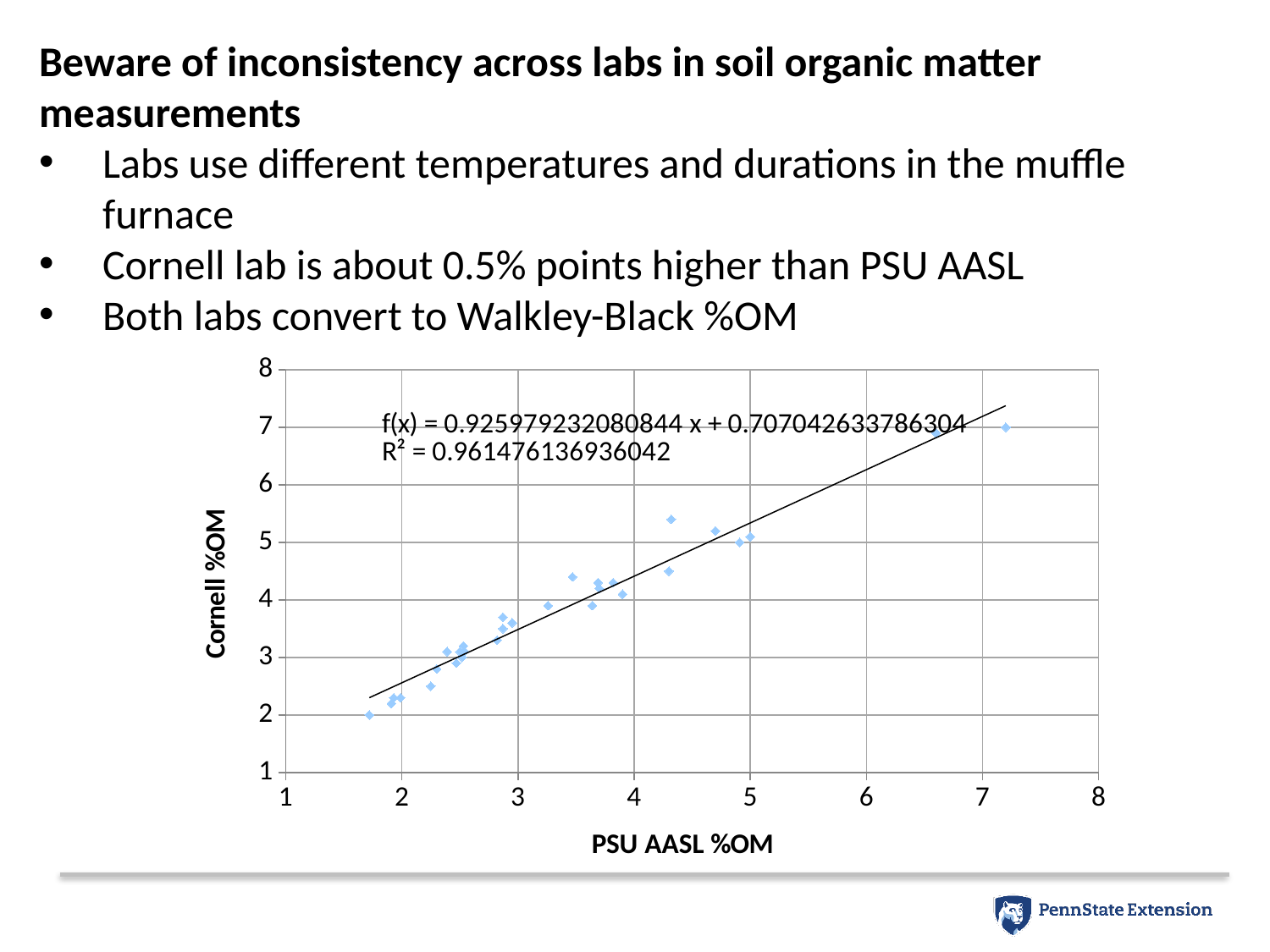
Is the highest Cornell %OM value plotted greater or less than 6? greater Do the Cornell %OM values rise or fall as PSU AASL %OM increases along the x axis? Rise Is the lowest Cornell %OM value plotted greater or less than 3? less Is the largest PSU AASL %OM value plotted greater or less than 7? greater What kind of chart is shown on the slide? Scatter chart What R² value is printed on the chart? R² = 0.961476136936042 What is the title of the y axis of the chart? Cornell %OM